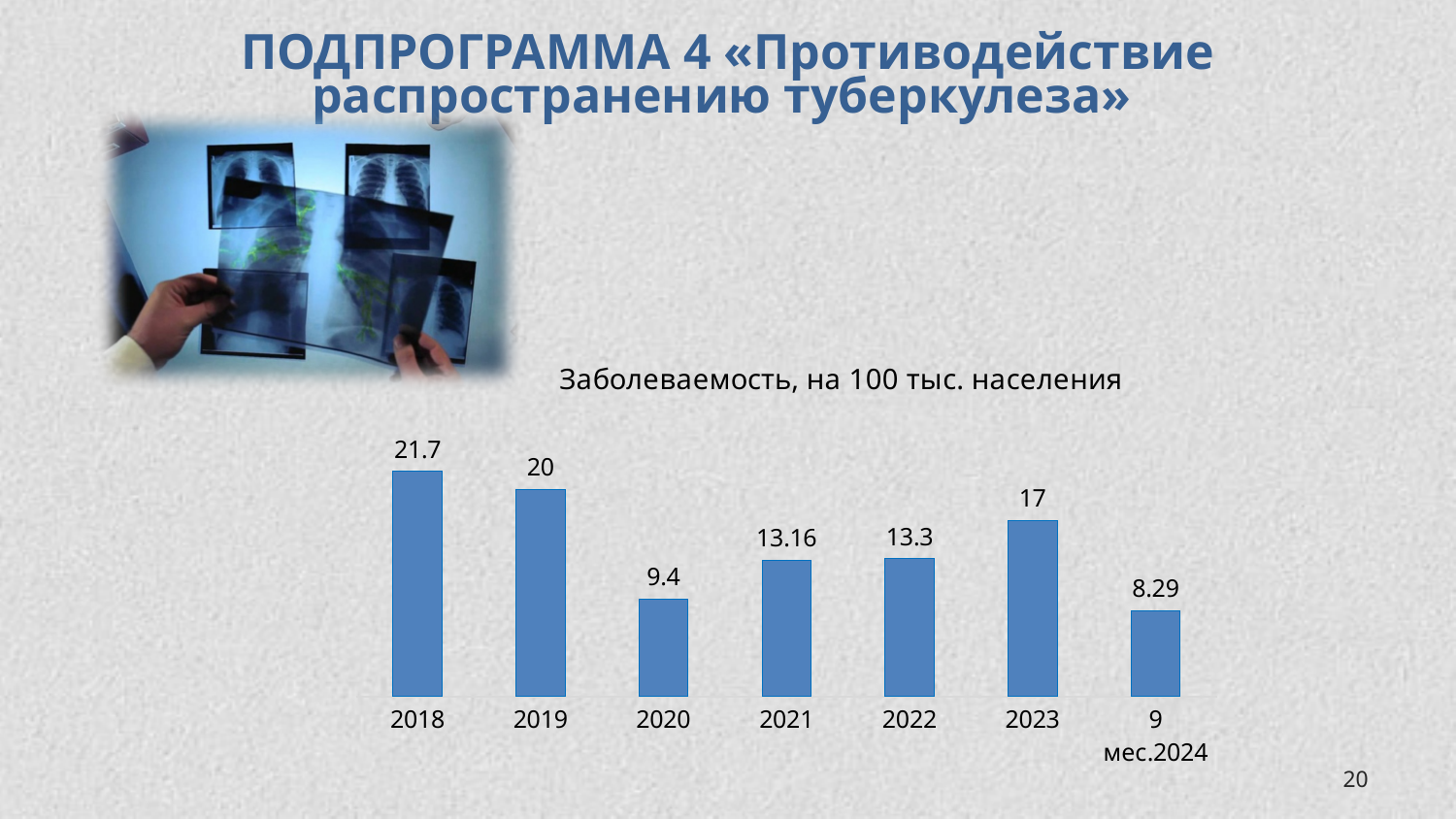
What is the incidence value for 2021? 13.16 Do the values rise or fall from 2018 to 2020? Fall What is the title of the chart? Заболеваемость, на 100 тыс. населения Which category has the lowest value on the chart? 9 мес.2024 What is the difference between the values for 2023 and 2020? 7.6 What is the difference between the values for 2018 and 2019? 1.7 What is the incidence value for 2018? 21.7 Which is larger, the value for 2022 or the value for 2023? 2023 How many bars are shown on the chart? 7 What kind of chart is shown on the slide? Bar chart What is the value shown for 9 мес.2024? 8.29 Which year has the highest incidence value? 2018